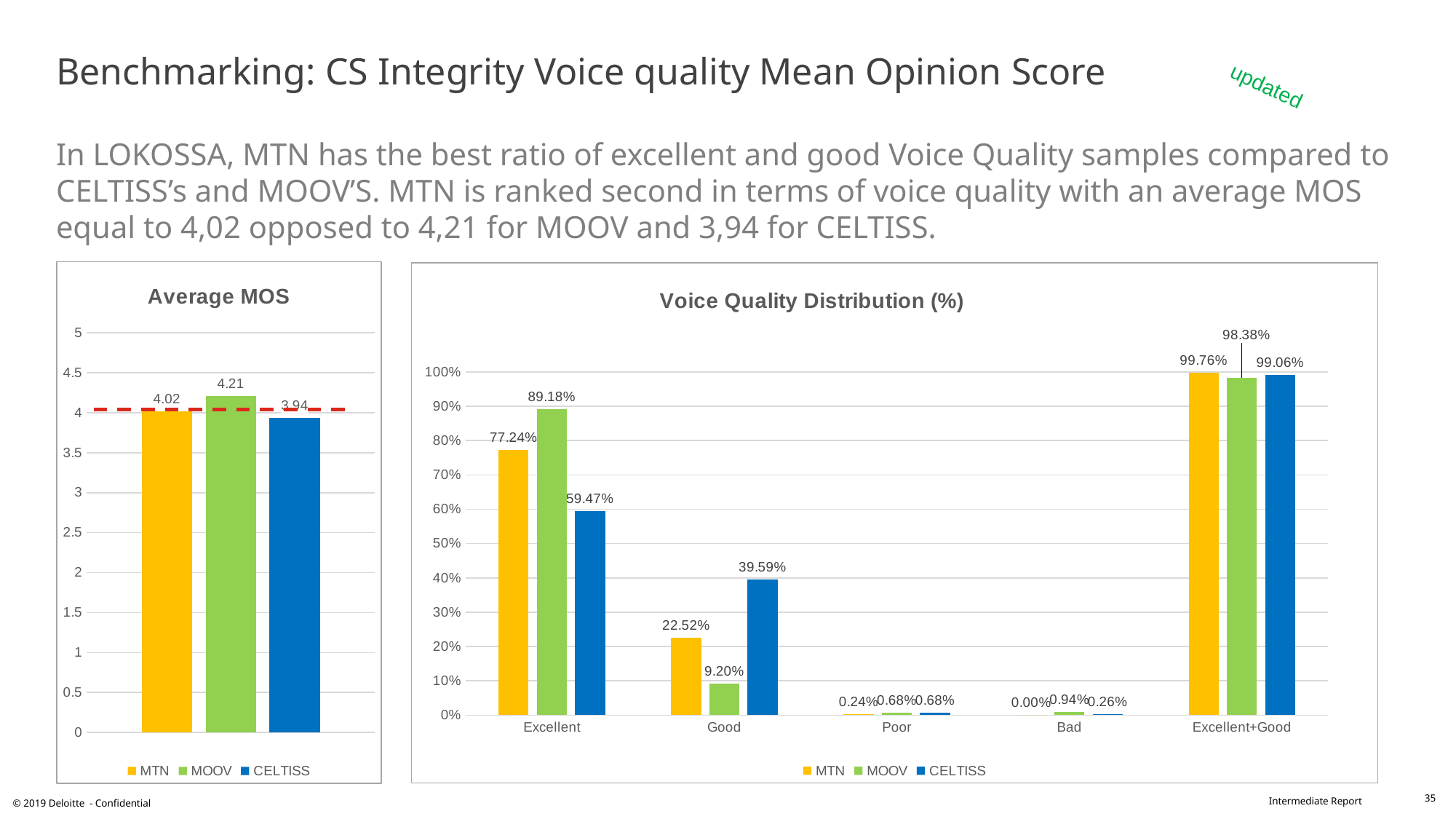
In the Voice Quality Distribution (%) chart, what is the value for CELTISS in the Excellent category? 59.47% In the Average MOS chart, what is the difference between MOOV's and MTN's average MOS? 0.19 In the Voice Quality Distribution (%) chart, how many categories are shown on the x axis? 5 In the Voice Quality Distribution (%) chart, what is the value for MOOV in the Good category? 9.20% In the Average MOS chart, how many series does the legend list? 3 In the Average MOS chart, which operator has the lowest average MOS? CELTISS In the Voice Quality Distribution (%) chart, what is the difference between MTN's and MOOV's values in the Excellent+Good category? 1.38% In the Voice Quality Distribution (%) chart, which is larger in the Good category: MTN or CELTISS? CELTISS In the Voice Quality Distribution (%) chart, what is the value for MTN in the Bad category? 0.00% What kind of chart is the Voice Quality Distribution (%) chart? Bar chart In the Voice Quality Distribution (%) chart, which operator has the highest value in the Excellent category? MOOV In the Average MOS chart, what is the average MOS for MOOV? 4.21